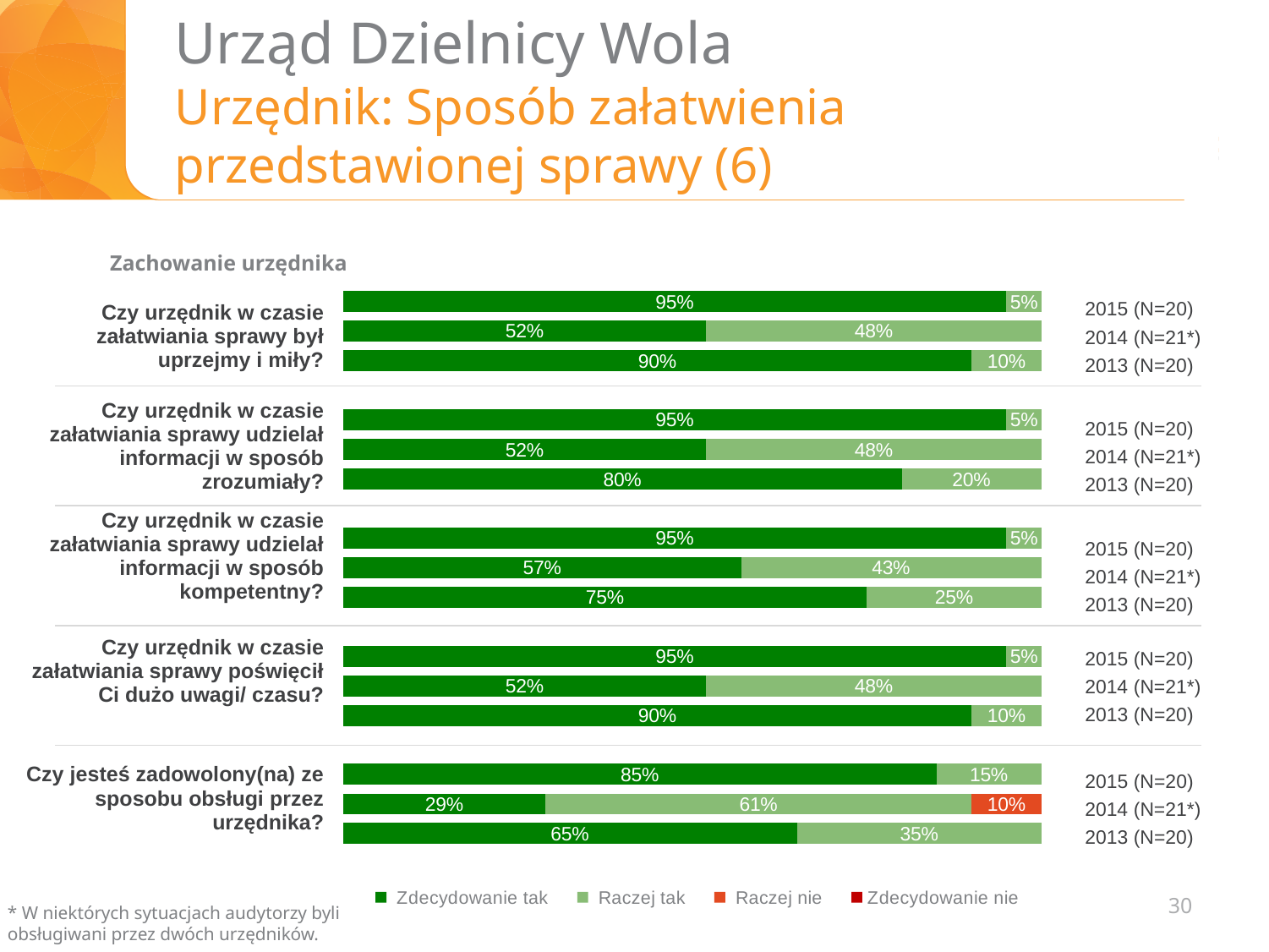
How many series does the legend list? 4 For "Czy urzędnik w czasie załatwiania sprawy był uprzejmy i miły?", which year has the lowest "Zdecydowanie tak" share? 2014 (N=21*) What is the "Raczej tak" value for 2013 for "Czy urzędnik w czasie załatwiania sprawy udzielał informacji w sposób kompetentny?"? 25% What percentage answered "Zdecydowanie tak" in 2015 to "Czy jesteś zadowolony(na) ze sposobu obsługi przez urzędnika?"? 85% What is the total of the 2014 bar for "Czy jesteś zadowolony(na) ze sposobu obsługi przez urzędnika?" (29% + 61% + 10%)? 100% In 2013, which question had the larger "Zdecydowanie tak" share: "udzielał informacji w sposób zrozumiały?" or "udzielał informacji w sposób kompetentny?"? udzielał informacji w sposób zrozumiały? For "Czy jesteś zadowolony(na) ze sposobu obsługi przez urzędnika?", which year has the highest "Zdecydowanie tak" share? 2015 (N=20) What is the "Raczej tak" value for 2014 for "Czy urzędnik w czasie załatwiania sprawy udzielał informacji w sposób kompetentny?"? 43% What is the "Raczej nie" value for 2014 for "Czy jesteś zadowolony(na) ze sposobu obsługi przez urzędnika?"? 10% How many questions (categories) are shown in the chart? 5 What kind of chart is shown on the slide? Stacked bar chart For "Czy jesteś zadowolony(na) ze sposobu obsługi przez urzędnika?", by how many percentage points does the 2015 "Zdecydowanie tak" value exceed the 2014 value? 56 percentage points